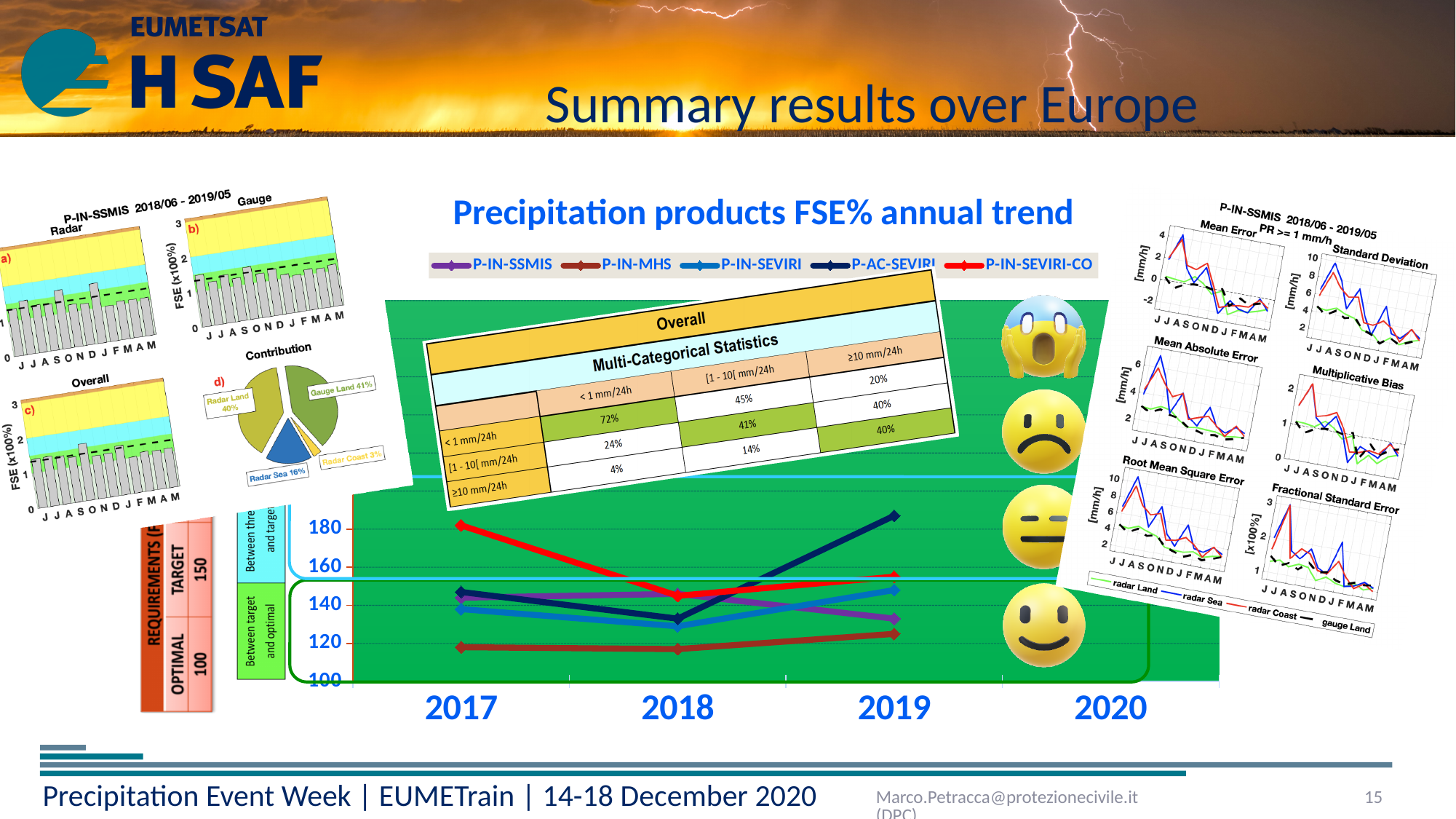
In the 'Precipitation products FSE% annual trend' chart, which series has the highest value in 2017? P-IN-SEVIRI-CO In the 'Contribution' pie chart, which slice is the smallest? Radar Coast In the 'Precipitation products FSE% annual trend' chart, is the value for P-IN-MHS in 2018 greater or less than 120? less In the 'Precipitation products FSE% annual trend' chart, which series has the lowest value in 2019? P-IN-MHS In the 'Precipitation products FSE% annual trend' chart, does the P-IN-SEVIRI-CO series rise or fall from 2017 to 2018? fall In the 'Precipitation products FSE% annual trend' chart, is the value for P-IN-SEVIRI-CO in 2017 greater or less than 160? greater In the 'Contribution' pie chart, what share does Gauge Land have? 41% In the 'Precipitation products FSE% annual trend' chart, is the value for P-AC-SEVIRI in 2019 greater or less than 180? greater In the 'Precipitation products FSE% annual trend' chart, how many years are labelled on the x axis? 4 In the 'Precipitation products FSE% annual trend' chart, how many series does the legend list? 5 In the 'Precipitation products FSE% annual trend' chart, which is larger in 2019: P-AC-SEVIRI or P-IN-SSMIS? P-AC-SEVIRI In the 'Precipitation products FSE% annual trend' chart, what kind of chart is used? line chart